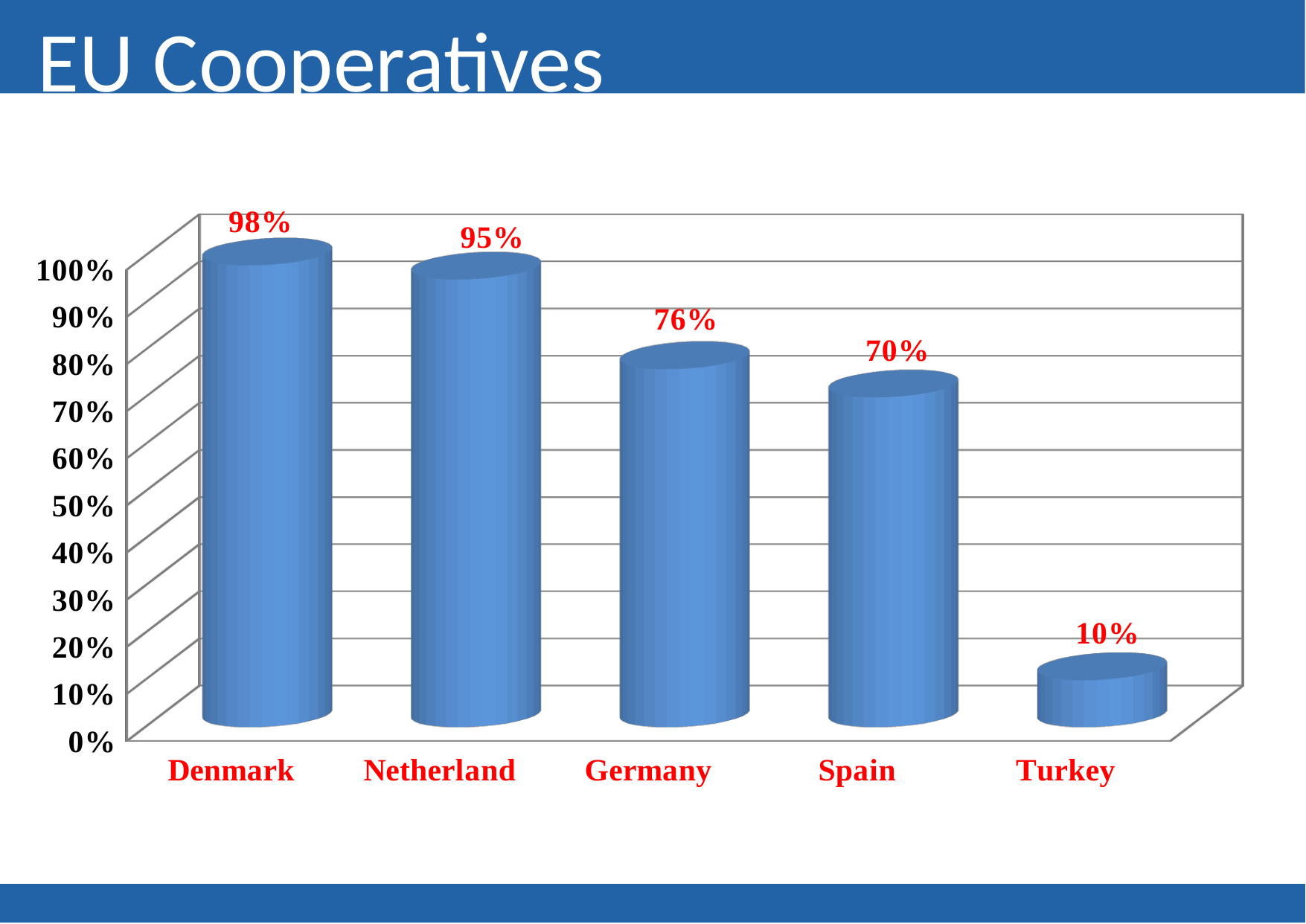
Do the values rise or fall from Denmark to Turkey along the x axis? fall What is the value for Germany? 76% Which country has the lowest value? Turkey Is the value for Spain greater or less than 60%? greater What is the value for Turkey? 10% What is the difference between the values for Netherland and Spain? 25% How many countries are shown in the chart? 5 What is the difference between the values for Germany and Turkey? 66% Which country has the highest value? Denmark Which is larger, the value for Germany or the value for Spain? Germany What kind of chart is shown on the slide? bar chart What is the value for Denmark? 98%